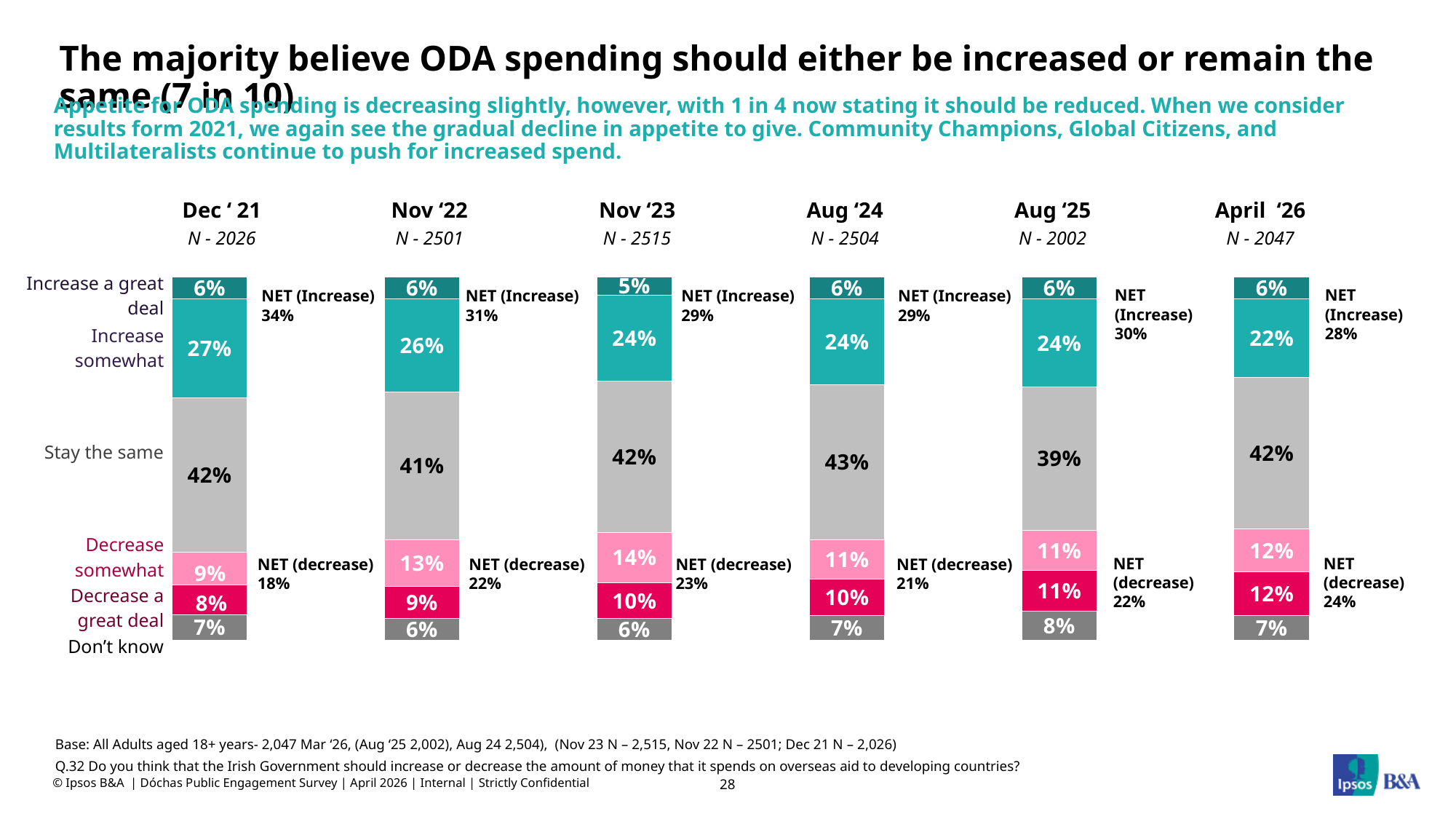
Is the 'Increase somewhat' value larger in Dec '21 or in Aug '25? Dec '21 How many survey waves are shown in the chart? 6 Does the NET (Increase) value rise or fall from Dec '21 to Nov '23? Fall Which wave has the lowest 'Stay the same' value? Aug '25 What percentage said 'Stay the same' in Aug '24? 43% What is the difference between the NET (Increase) values for Dec '21 and April '26? 6% What is the NET (decrease) figure for April '26? 24% What is the NET (Increase) figure for Dec '21? 34% Which wave has the highest 'Decrease somewhat' value? Nov '23 What type of chart is shown on the slide? Stacked bar chart What is the 'Increase somewhat' value for April '26? 22% What is the sample size (N) shown for Nov '22? 2501